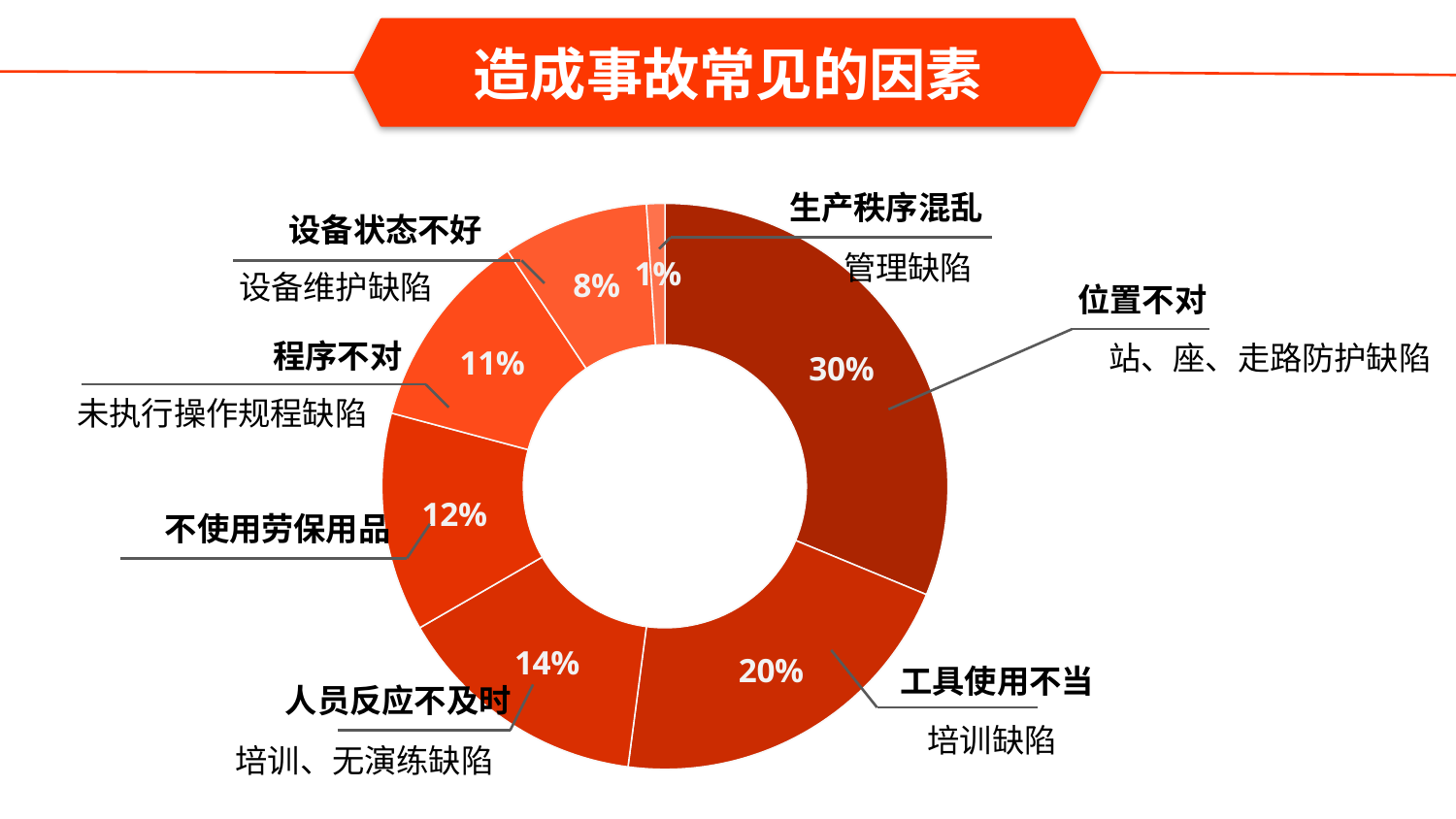
What percentage is shown for 设备状态不好? 8% Which factor has the smallest share of the chart? 生产秩序混乱 What percentage is shown for 人员反应不及时? 14% Which factor has the largest share of the chart? 位置不对 What percentage is shown for 工具使用不当? 20% What percentage is shown for 程序不对? 11% What percentage is shown for 不使用劳保用品? 12% What is the title of the slide? 造成事故常见的因素 How many slices does the chart have? 7 What kind of chart is shown on the slide? Donut (pie) chart What is the difference in percentage points between 位置不对 and 工具使用不当? 10 What percentage is shown for 位置不对? 30%